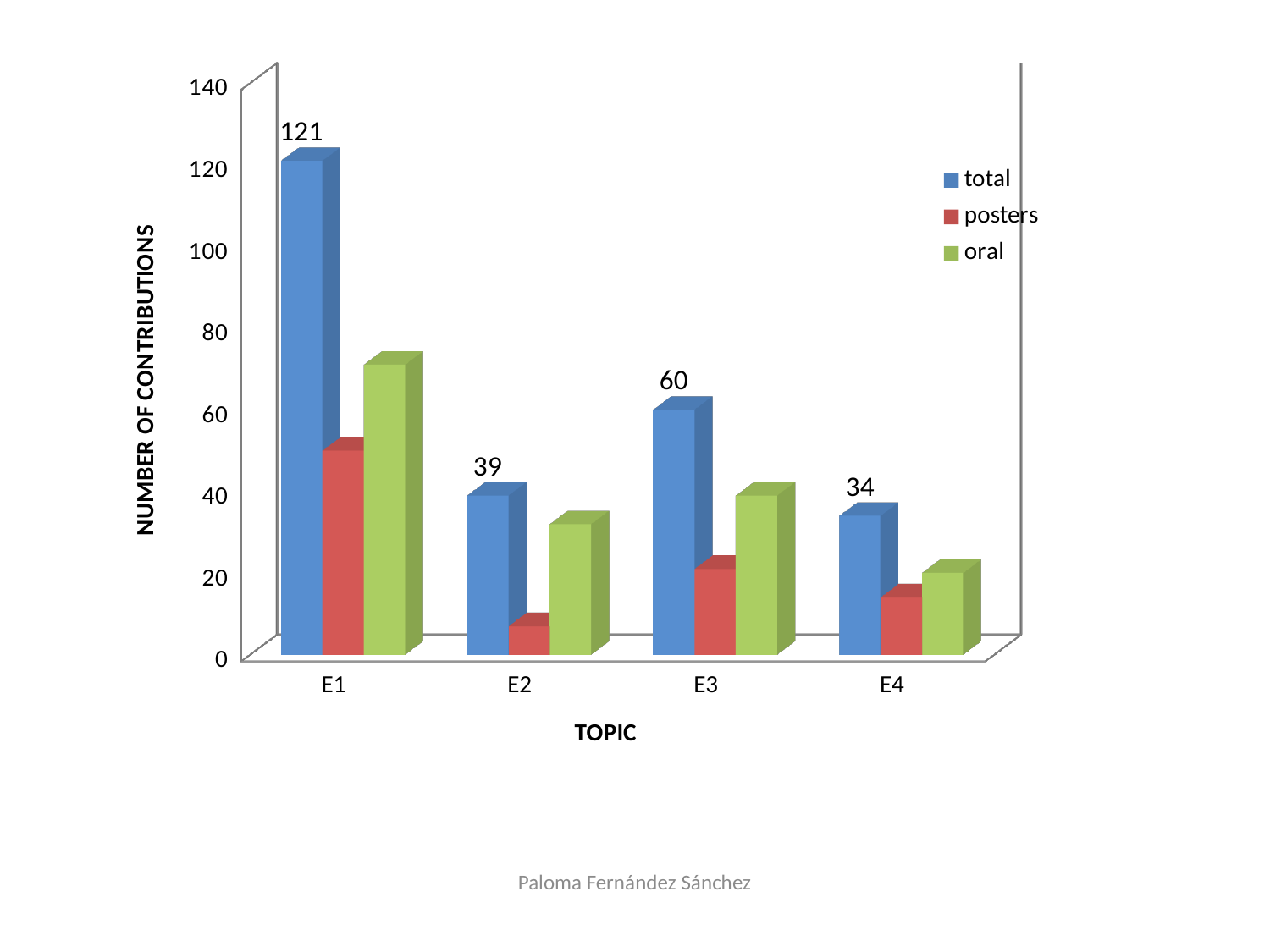
What is the total number of contributions for topic E4? 34 What is the difference between the total contributions for E1 and E2? 82 What kind of chart is shown on the slide? Bar chart Is the value for posters in E2 greater or less than 20? less Is the value for oral contributions in E1 greater or less than 60? greater Which topic has the lowest total number of contributions? E4 How many series does the legend list? 3 Which topic has the highest total number of contributions? E1 What is the total number of contributions for topic E1? 121 Which topic has more total contributions, E2 or E3? E3 What is the total number of contributions for topic E3? 60 How many topics are shown on the x axis? 4